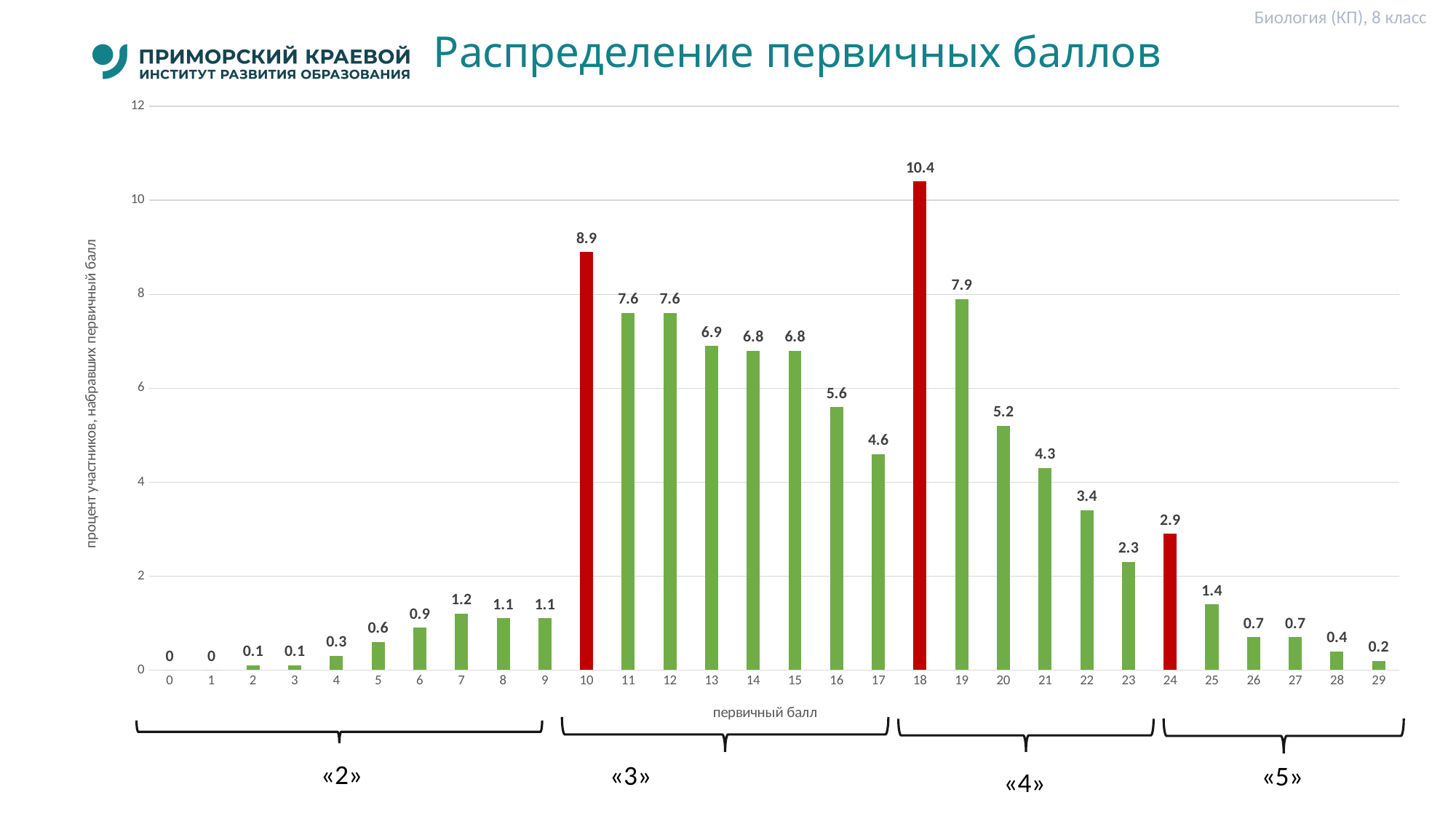
What is the difference between the values for primary scores 18 and 10? 1.5 What kind of chart is shown on the slide? Bar chart What is the value for primary score 18? 10.4 Which is larger, the value for primary score 16 or for primary score 21? 16 Which primary scores are shown with red bars? 10, 18 and 24 How many primary score categories are shown on the x axis? 30 What is the value for primary score 7? 1.2 Do the values rise or fall from primary score 18 to primary score 23? Fall What is the value for primary score 10? 8.9 What is the difference between the values for primary scores 19 and 20? 2.7 What is the value for primary score 24? 2.9 Which primary score has the highest percentage of participants? 18